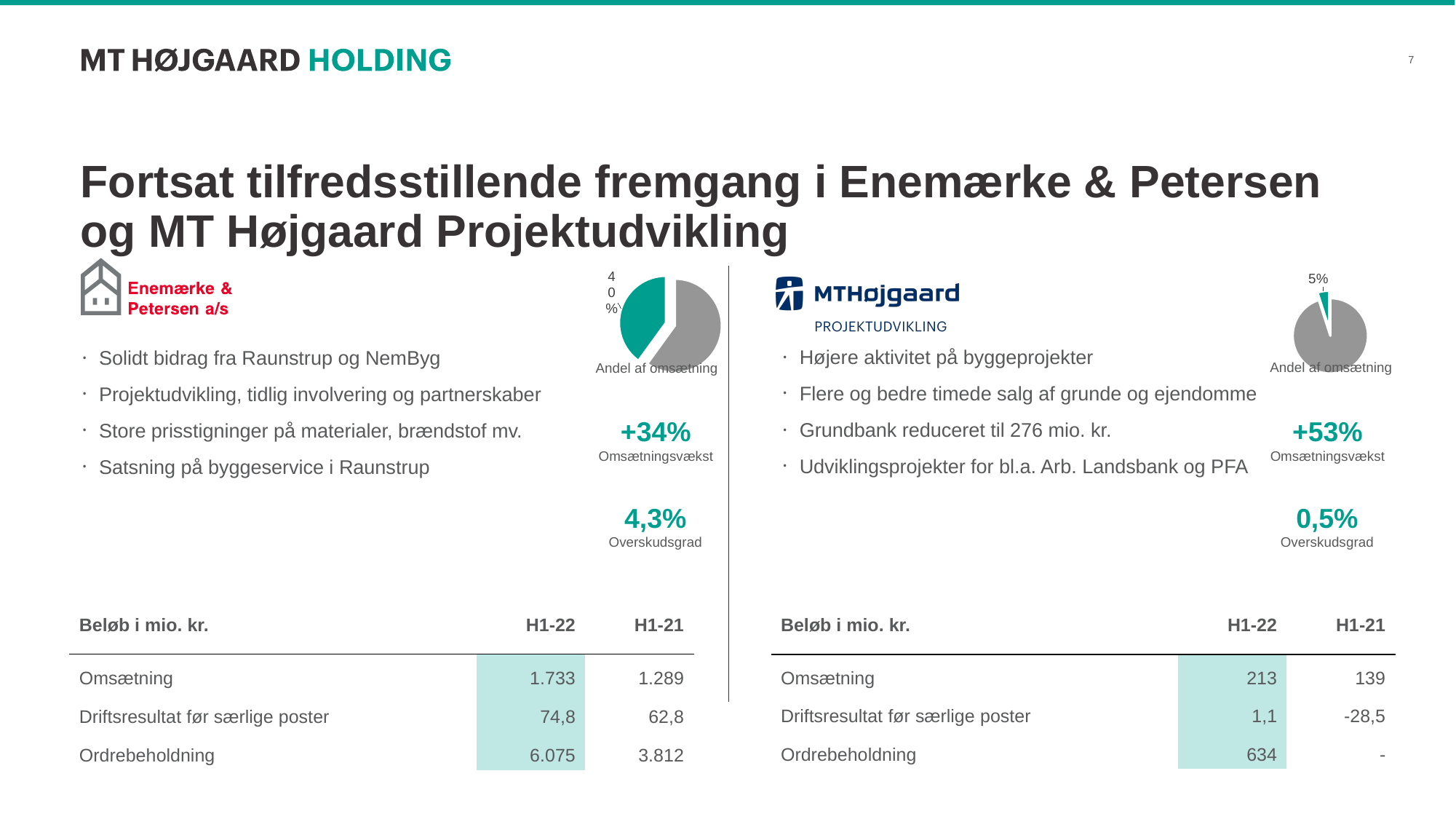
What is the caption printed under both pie charts? Andel af omsætning In the left pie chart (Enemærke & Petersen), what share of revenue (Andel af omsætning) is shown by the highlighted slice? 40% What colour is the highlighted slice in the left pie chart (Enemærke & Petersen)? Teal (green) How many slices does the right pie chart (MT Højgaard Projektudvikling) have? 2 What kind of chart is shown next to the Enemærke & Petersen logo on the left side of the slide? Pie chart What kind of chart is shown next to the MT Højgaard Projektudvikling logo on the right side of the slide? Pie chart Which pie chart shows the larger highlighted share of revenue, the one for Enemærke & Petersen or the one for MT Højgaard Projektudvikling? Enemærke & Petersen In the right pie chart (MT Højgaard Projektudvikling), is the highlighted slice greater or less than 50% of the pie? less What is the difference between the highlighted share in the Enemærke & Petersen pie chart and the highlighted share in the MT Højgaard Projektudvikling pie chart? 35 percentage points In the left pie chart (Enemærke & Petersen), is the grey slice larger or smaller than the teal slice? larger How many slices does the left pie chart (Enemærke & Petersen) have? 2 In the right pie chart (MT Højgaard Projektudvikling), what share of revenue (Andel af omsætning) is shown by the highlighted slice? 5%